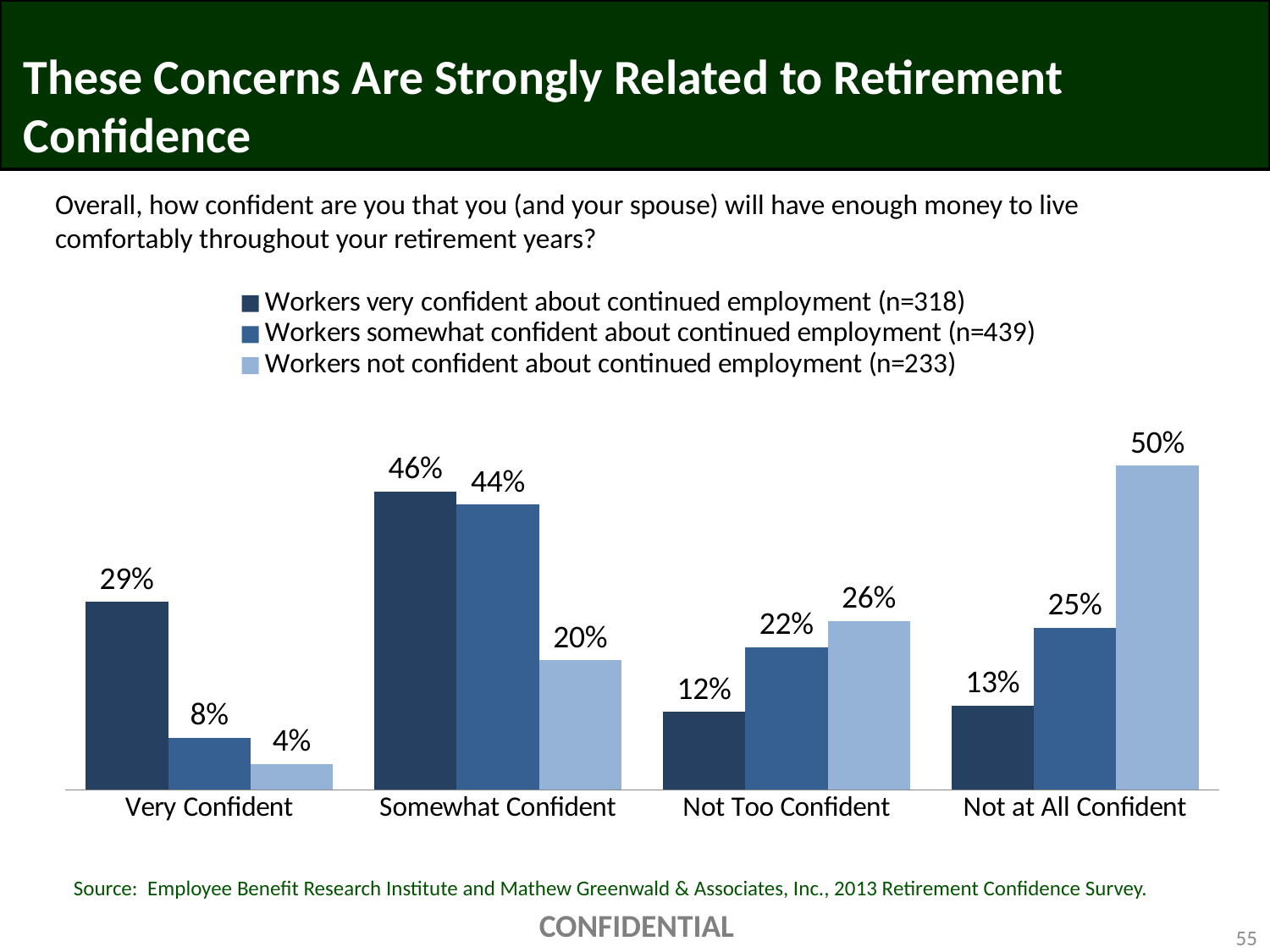
Do the values for workers not confident about continued employment rise or fall from Somewhat Confident to Not at All Confident? Rise What percentage of workers very confident about continued employment are Very Confident about retirement? 29% In the Not at All Confident category, which series has the larger value: workers somewhat confident or workers not confident about continued employment? Workers not confident about continued employment What is the sample size (n) for workers somewhat confident about continued employment shown in the legend? 439 What is the value for workers somewhat confident about continued employment in the Not Too Confident category? 22% What kind of chart is shown on the slide? Bar chart Which retirement confidence category has the highest value for workers very confident about continued employment? Somewhat Confident How many series does the legend list? 3 What is the difference between the values for workers very confident and workers not confident about continued employment in the Very Confident category? 25% Which retirement confidence category has the lowest value for workers not confident about continued employment? Very Confident What percentage of workers not confident about continued employment are Not at All Confident about retirement? 50% How many retirement confidence categories are shown on the x axis? 4